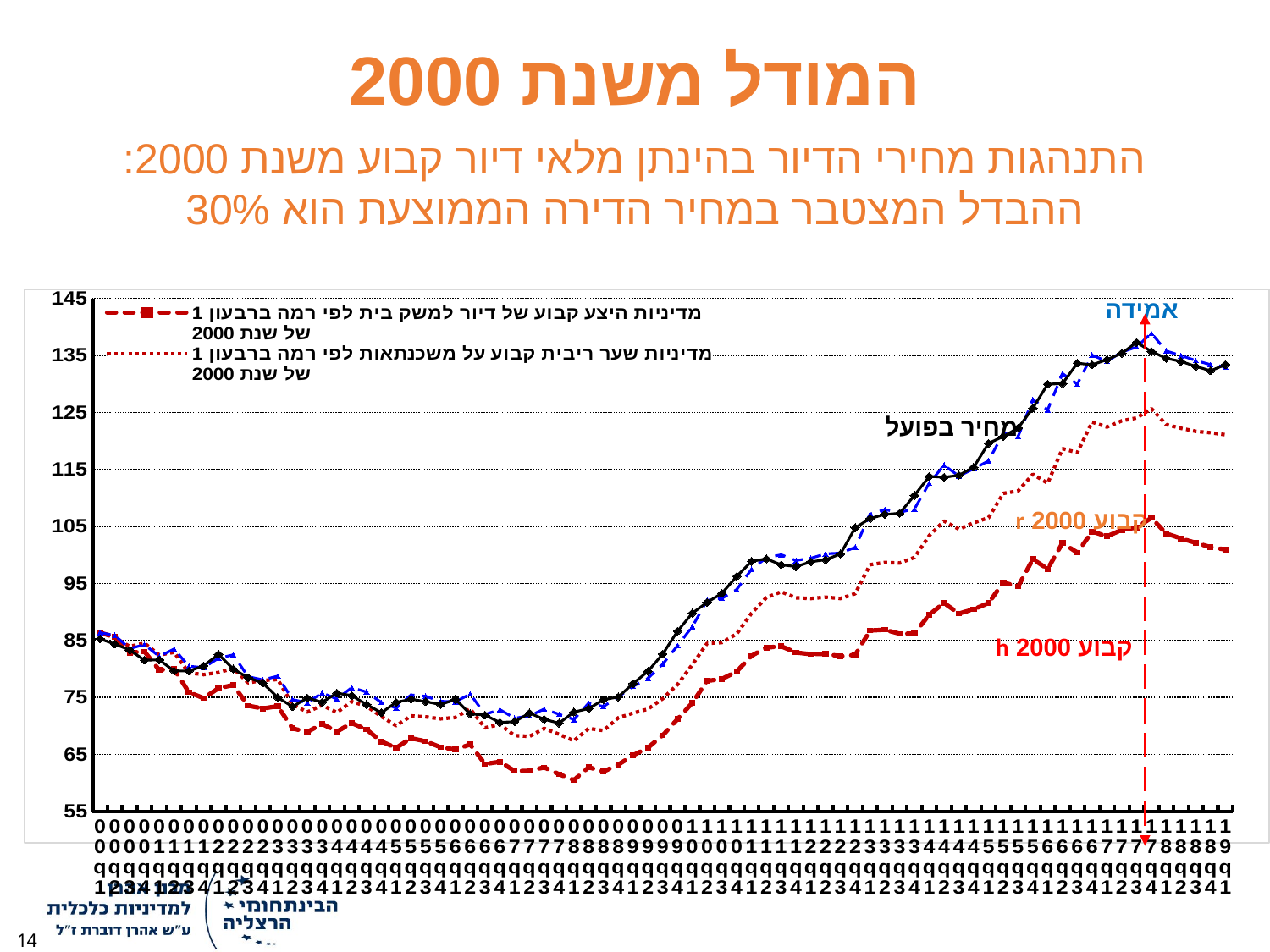
Is the peak value of the black 'מחיר בפועל' line (around 2017) greater or less than 125? greater Around 2017, which line is higher: 'קבוע r 2000' or 'קבוע h 2000'? קבוע r 2000 How many series does the chart's legend list? 2 What is the label written next to the black solid line? מחיר בפועל Between 2008 and 2017, does the black 'מחיר בפועל' line rise or fall? rise At the end of the series, which line is higher: 'מחיר בפועל' or 'קבוע h 2000'? מחיר בפועל What is the highest value shown on the chart's vertical axis? 145 Between 2000 and 2007, does the red dashed 'קבוע h 2000' line rise or fall overall? fall Is the value of the red dotted 'קבוע r 2000' line at the end of the series greater or less than 115? greater What kind of chart is shown on the slide? line chart Is the lowest value of the red dashed 'קבוע h 2000' line (around 2008) greater or less than 65? less